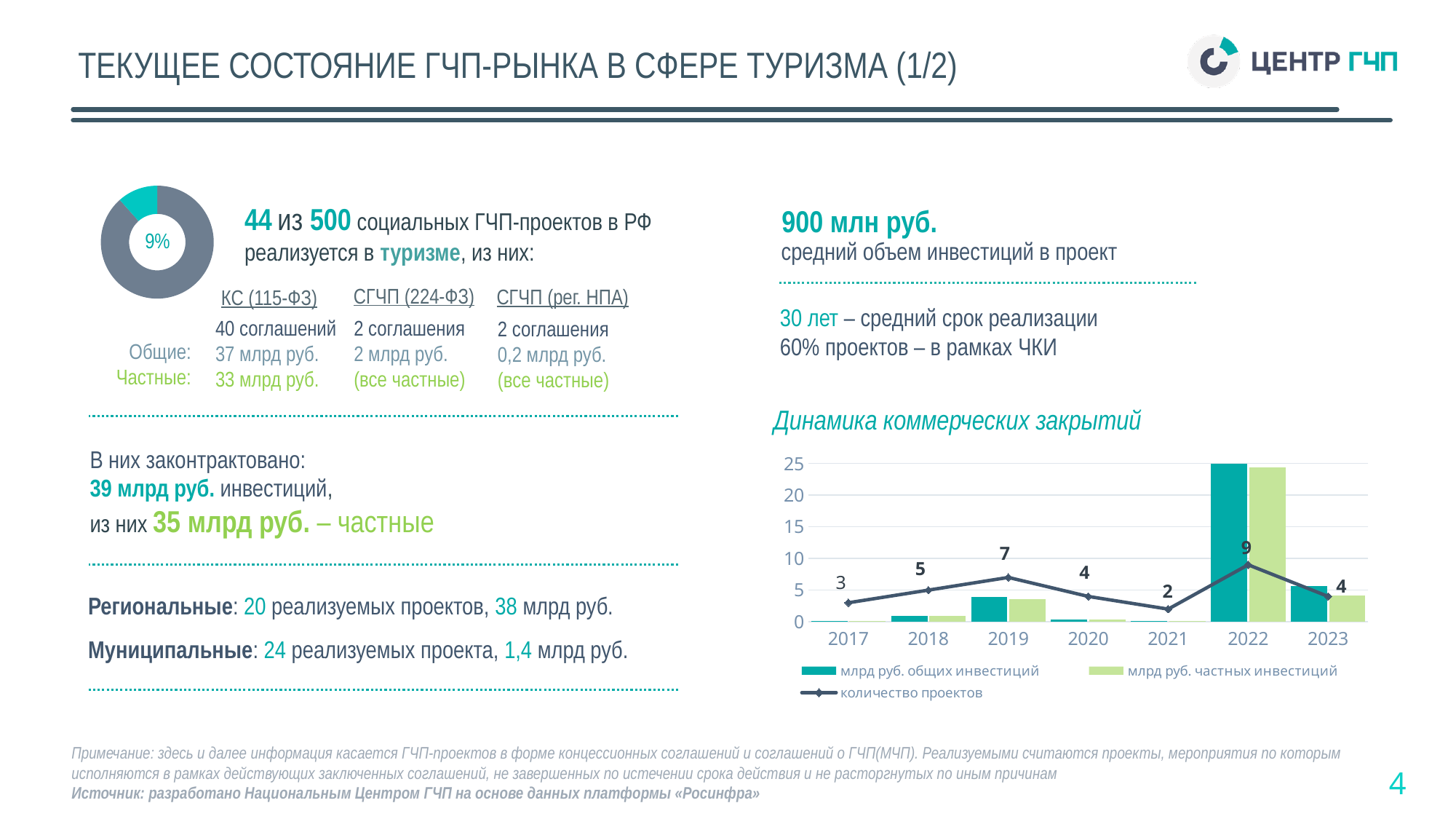
In the chart 'Динамика коммерческих закрытий', which year has more projects, 2018 or 2019? 2019 In the chart 'Динамика коммерческих закрытий', does the number of projects rise or fall from 2019 to 2021? fall In the chart 'Динамика коммерческих закрытий', what is the number of projects for 2021? 2 In the chart 'Динамика коммерческих закрытий', which year has the lowest number of projects? 2021 In the chart 'Динамика коммерческих закрытий', what is the difference between the number of projects in 2022 and in 2021? 7 In the chart 'Динамика коммерческих закрытий', which year has the highest number of projects? 2022 In the chart 'Динамика коммерческих закрытий', how many projects (количество проектов) are shown for 2019? 7 In the chart 'Динамика коммерческих закрытий', how many series does the legend list? 3 In the chart 'Динамика коммерческих закрытий', how many years are shown on the x axis? 7 What percentage is shown in the donut chart on the left of the slide? 9% In the chart 'Динамика коммерческих закрытий', is the value of 'млрд руб. общих инвестиций' for 2022 greater or less than 20? greater In the chart 'Динамика коммерческих закрытий', is the value of 'млрд руб. общих инвестиций' for 2019 greater or less than 5? less